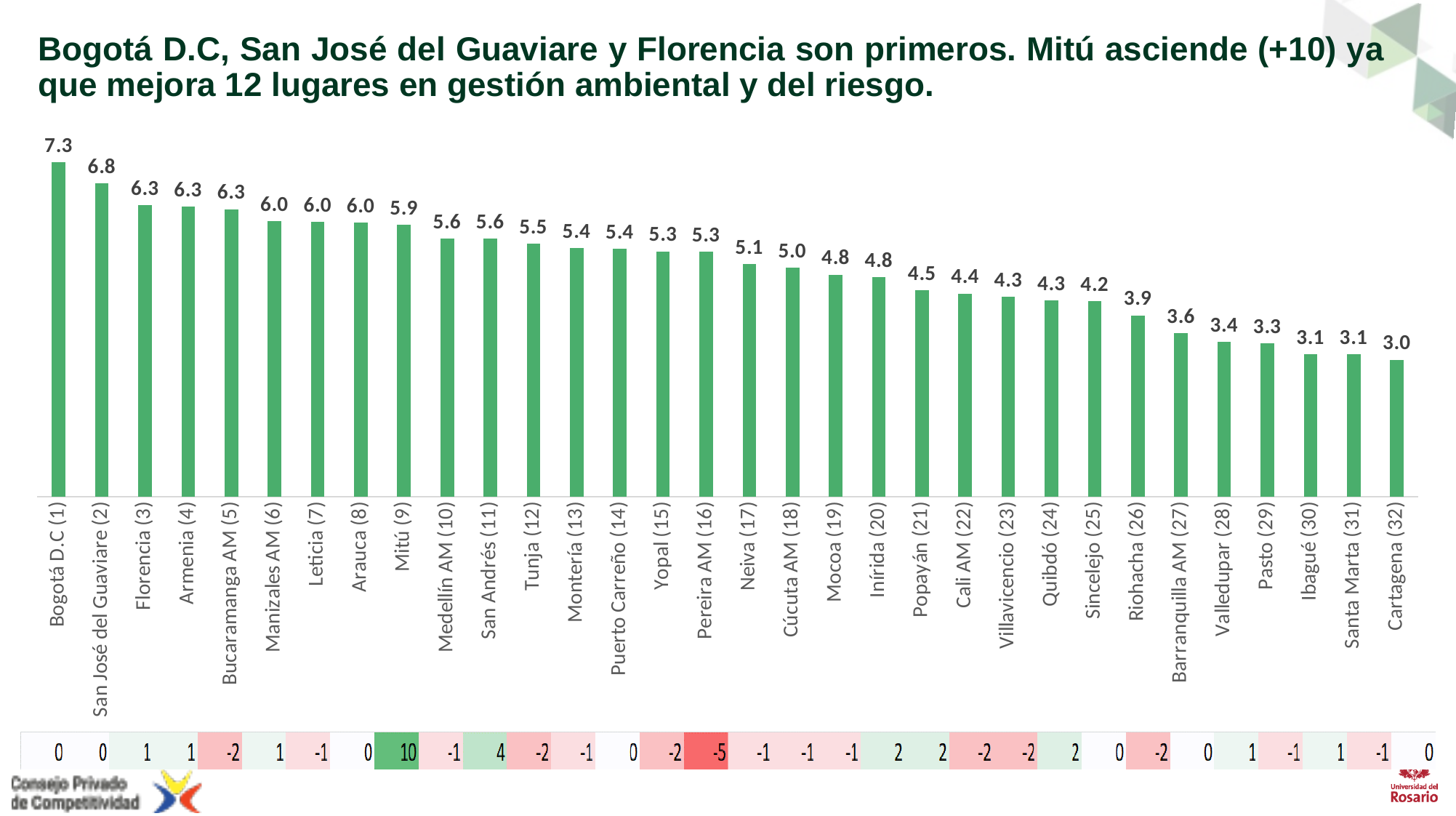
Which has a larger value, Mitú (9) or Neiva (17)? Mitú (9) What is the value for Bogotá D.C (1)? 7.3 What is the value for Cúcuta AM (18)? 5.0 What is the value for Riohacha (26)? 3.9 Do the values rise or fall from left to right along the x axis? Fall What kind of chart is shown on the slide? Bar chart What is the difference between the values for San José del Guaviare (2) and Florencia (3)? 0.5 What is the value for Mitú (9)? 5.9 Which city has the lowest value? Cartagena (32) Which city has the highest value? Bogotá D.C (1) How many cities are shown in the chart? 32 What is the difference between the values for Bogotá D.C (1) and Cartagena (32)? 4.3